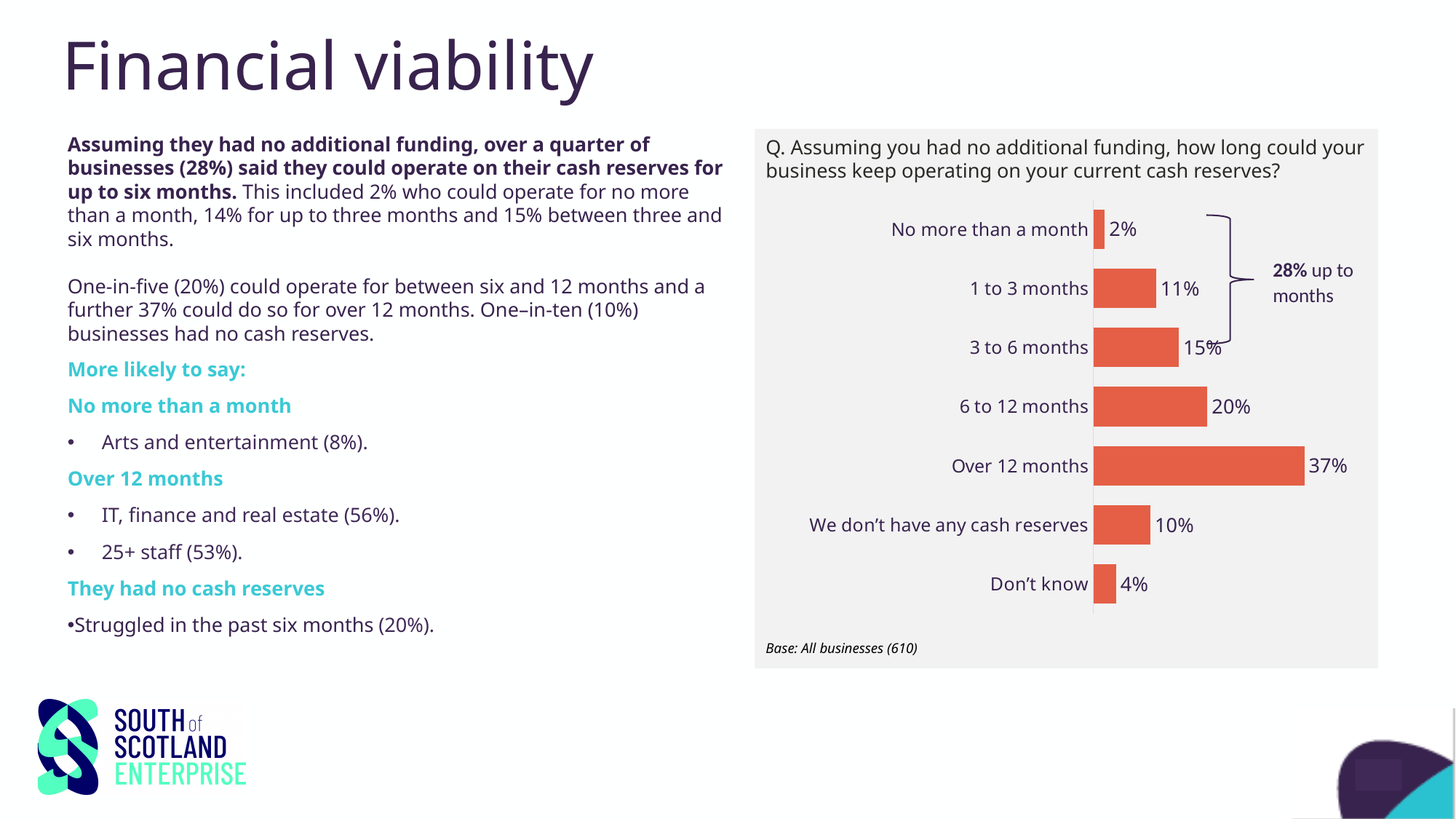
What is the difference between the values for 'Over 12 months' and '6 to 12 months'? 17% Which category has the highest value in the chart? Over 12 months How many categories are shown in the chart? 7 What is the combined total of the three categories grouped by the bracket (No more than a month, 1 to 3 months, 3 to 6 months)? 28% Which is larger: the value for '3 to 6 months' or the value for 'We don't have any cash reserves'? 3 to 6 months What type of chart is shown on the slide? Bar chart What percentage of businesses answered 'Don't know'? 4% What is the base (number of respondents) stated below the chart? All businesses (610) What percentage of businesses said they could keep operating for over 12 months? 37% What percentage of businesses said they don't have any cash reserves? 10% What percentage of businesses said they could operate for 1 to 3 months? 11% Which category has the lowest value in the chart? No more than a month